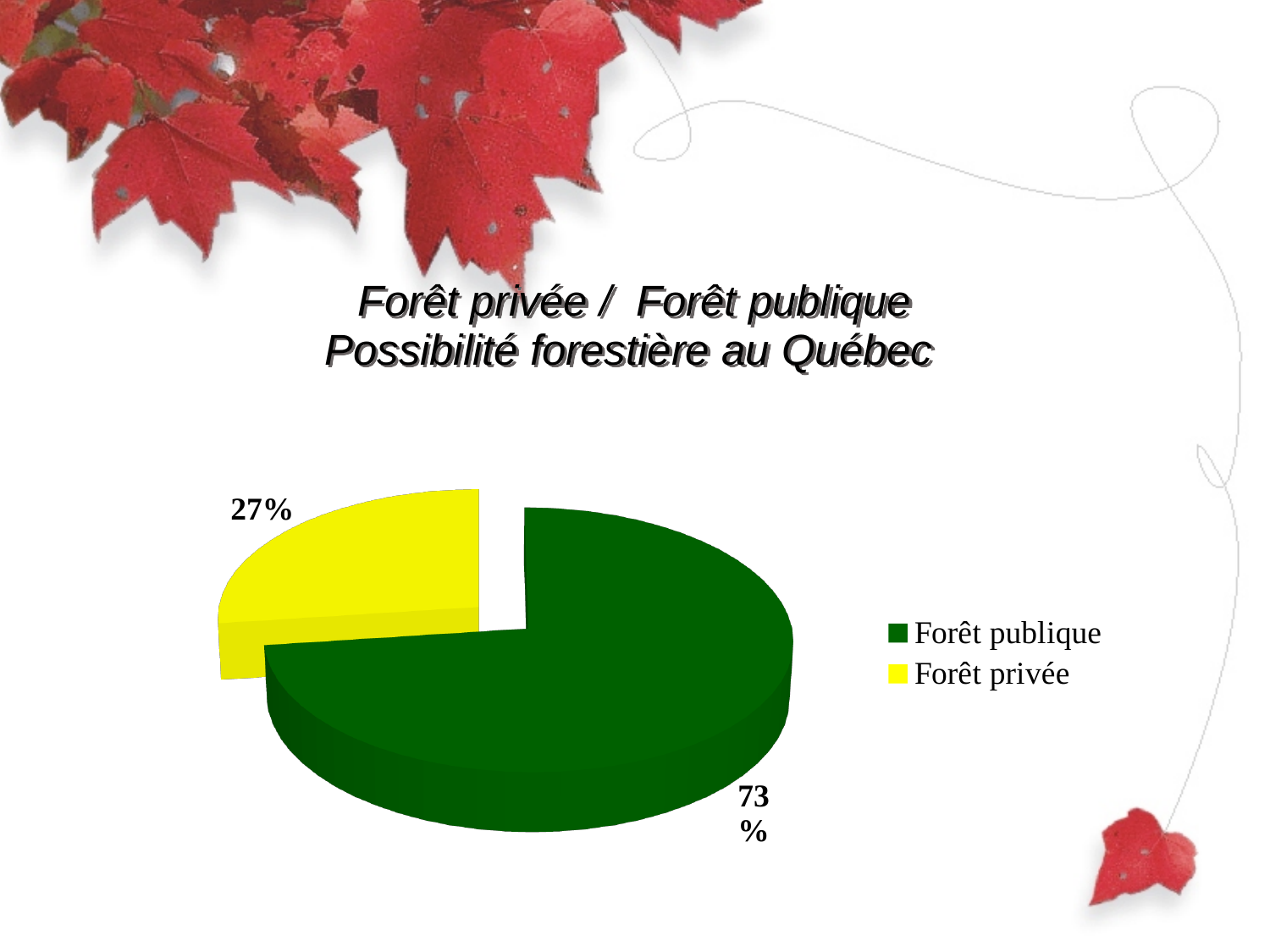
What kind of chart is shown on the slide? pie chart What share of the pie does Forêt privée represent? 27% Which category has the largest slice of the pie? Forêt publique What share of the pie does Forêt publique represent? 73% How many slices does the pie chart have? 2 What colour is the slice for Forêt privée? yellow What is the difference in percentage points between Forêt publique and Forêt privée? 46 How many entries does the legend list? 2 What colour is the slice for Forêt publique? green Which is larger, the slice for Forêt publique or the slice for Forêt privée? Forêt publique Which category has the smallest slice of the pie? Forêt privée